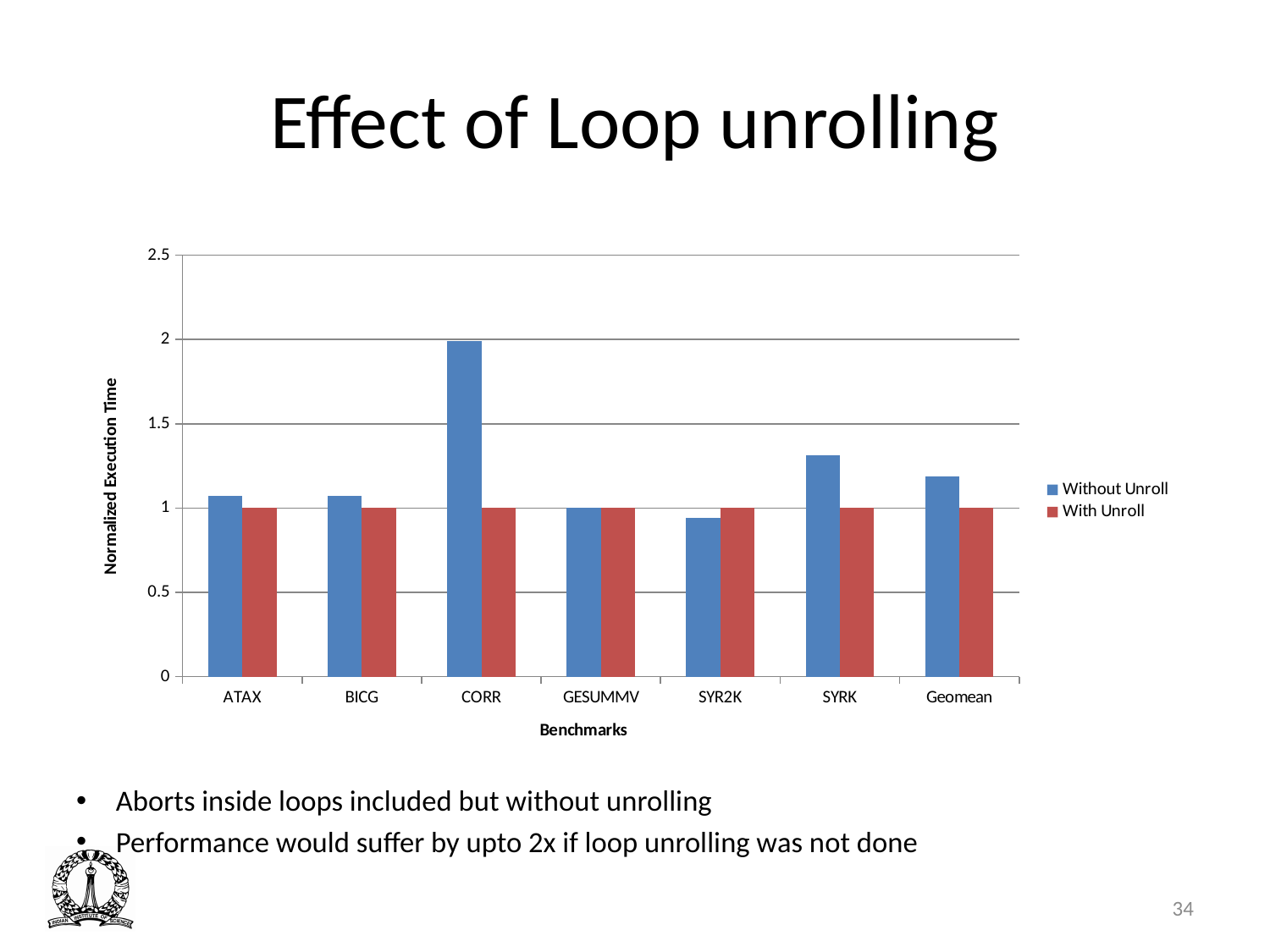
What is the label on the y axis of the chart? Normalized Execution Time Is the Without Unroll value for SYR2K greater or less than 1? less Is the Without Unroll value for Geomean greater or less than 1.5? less Which benchmark has the highest Without Unroll value? CORR How many series does the legend list? 2 How many benchmark categories are shown on the x axis? 7 What kind of chart is shown on the slide? bar chart Is the Without Unroll value for CORR greater or less than 1.5? greater For ATAX, which is larger: the Without Unroll value or the With Unroll value? Without Unroll For SYR2K, which is larger: the Without Unroll value or the With Unroll value? With Unroll Which benchmark has the lowest Without Unroll value? SYR2K